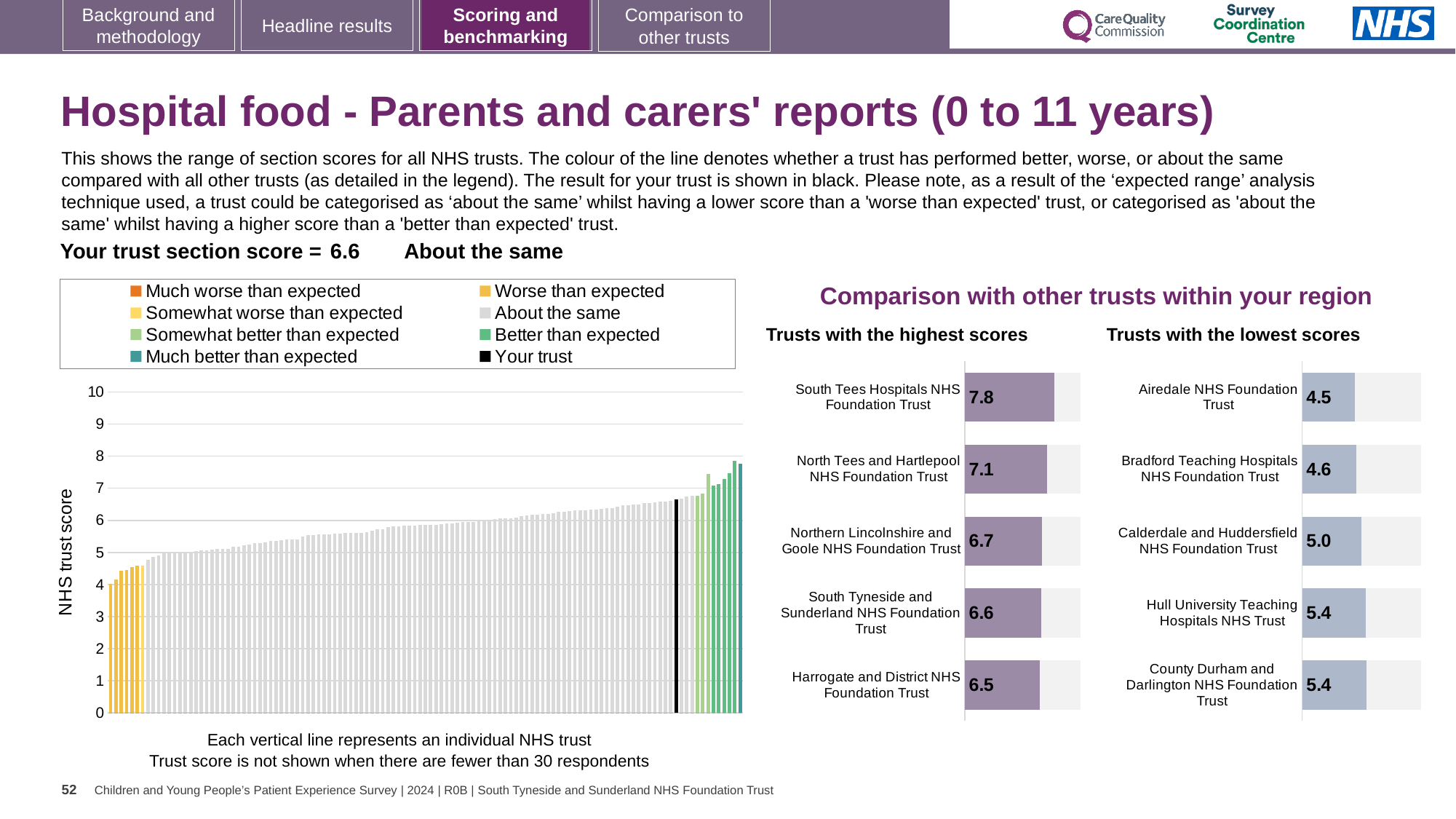
In the 'Trusts with the highest scores' chart, which trust has the highest score? South Tees Hospitals NHS Foundation Trust In the 'Trusts with the lowest scores' chart, which trust has the lowest score? Airedale NHS Foundation Trust What kind of chart is the large chart on the left showing NHS trust scores? Bar chart In the 'Trusts with the lowest scores' chart, which has the higher score: Bradford Teaching Hospitals NHS Foundation Trust or Hull University Teaching Hospitals NHS Trust? Hull University Teaching Hospitals NHS Trust How many entries does the legend above the large chart on the left list? 8 What is the y-axis label of the large chart on the left? NHS trust score In the 'Trusts with the lowest scores' chart, what is the score for Calderdale and Huddersfield NHS Foundation Trust? 5.0 In the large chart on the left, what is the section score for your trust (shown in black)? 6.6 How many trusts are shown in the 'Trusts with the highest scores' chart? 5 In the 'Trusts with the highest scores' chart, what is the difference between the scores of South Tees Hospitals NHS Foundation Trust and Harrogate and District NHS Foundation Trust? 1.3 In the 'Trusts with the highest scores' chart, what is the score for South Tees Hospitals NHS Foundation Trust? 7.8 In the large chart on the left, do the trust scores rise or fall from left to right? Rise